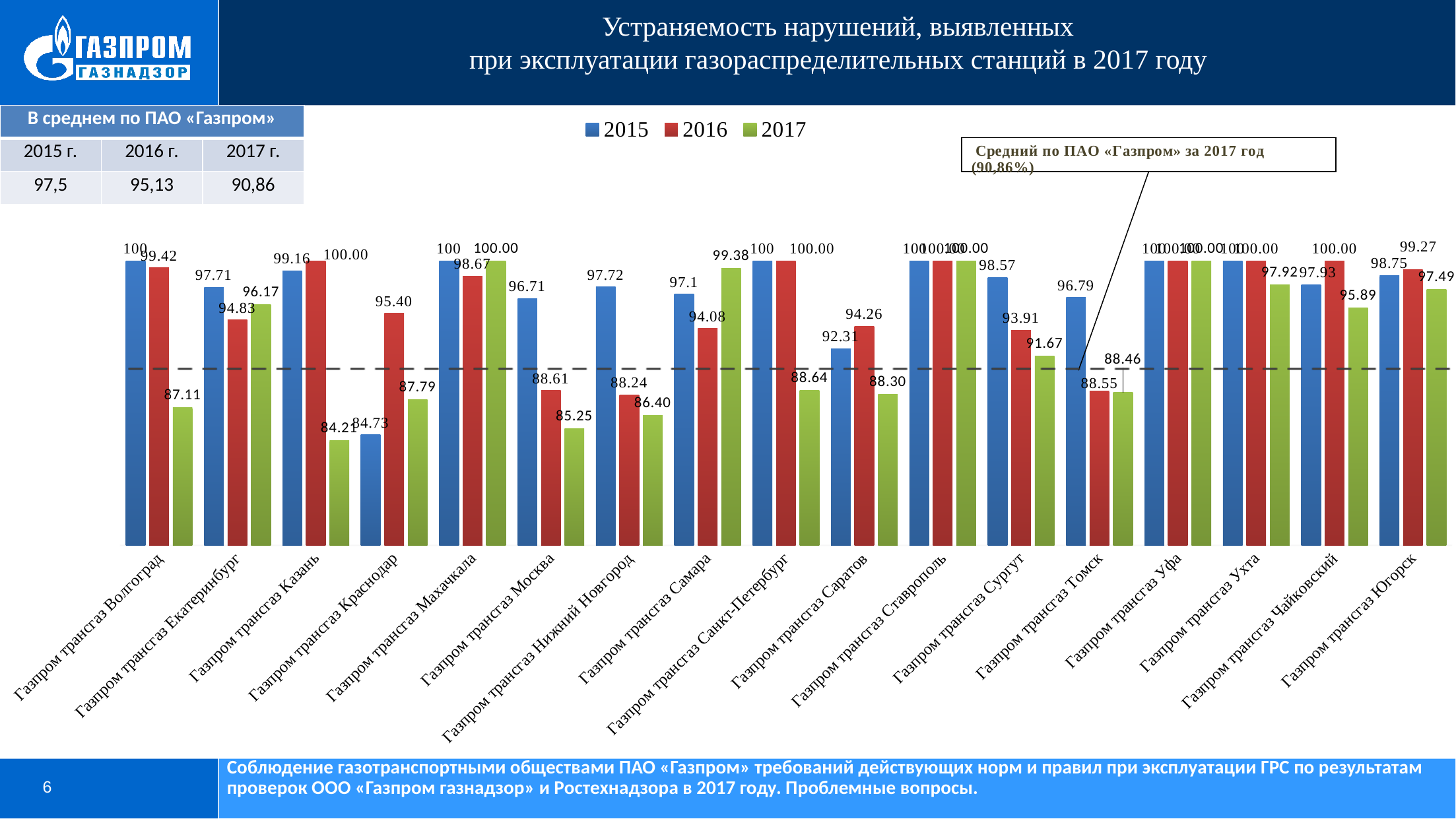
What is the 2015 value for Газпром трансгаз Саратов? 92.31 Which is larger for Газпром трансгаз Самара: the 2016 value or the 2017 value? 2017 What is the difference between the 2015 and 2017 values for Газпром трансгаз Москва? 11.46 How many categories are shown on the x axis? 17 What is the 2017 value for Газпром трансгаз Волгоград? 87.11 Which category has the lowest 2015 value? Газпром трансгаз Краснодар What kind of chart is shown on the slide? Bar chart What value does the callout give as the average for ПАО «Газпром» in 2017? 90,86% Which category has the lowest 2017 value? Газпром трансгаз Казань What is the 2017 value for Газпром трансгаз Югорск? 97.49 How many series does the legend list? 3 What is the 2016 value for Газпром трансгаз Краснодар? 95.40